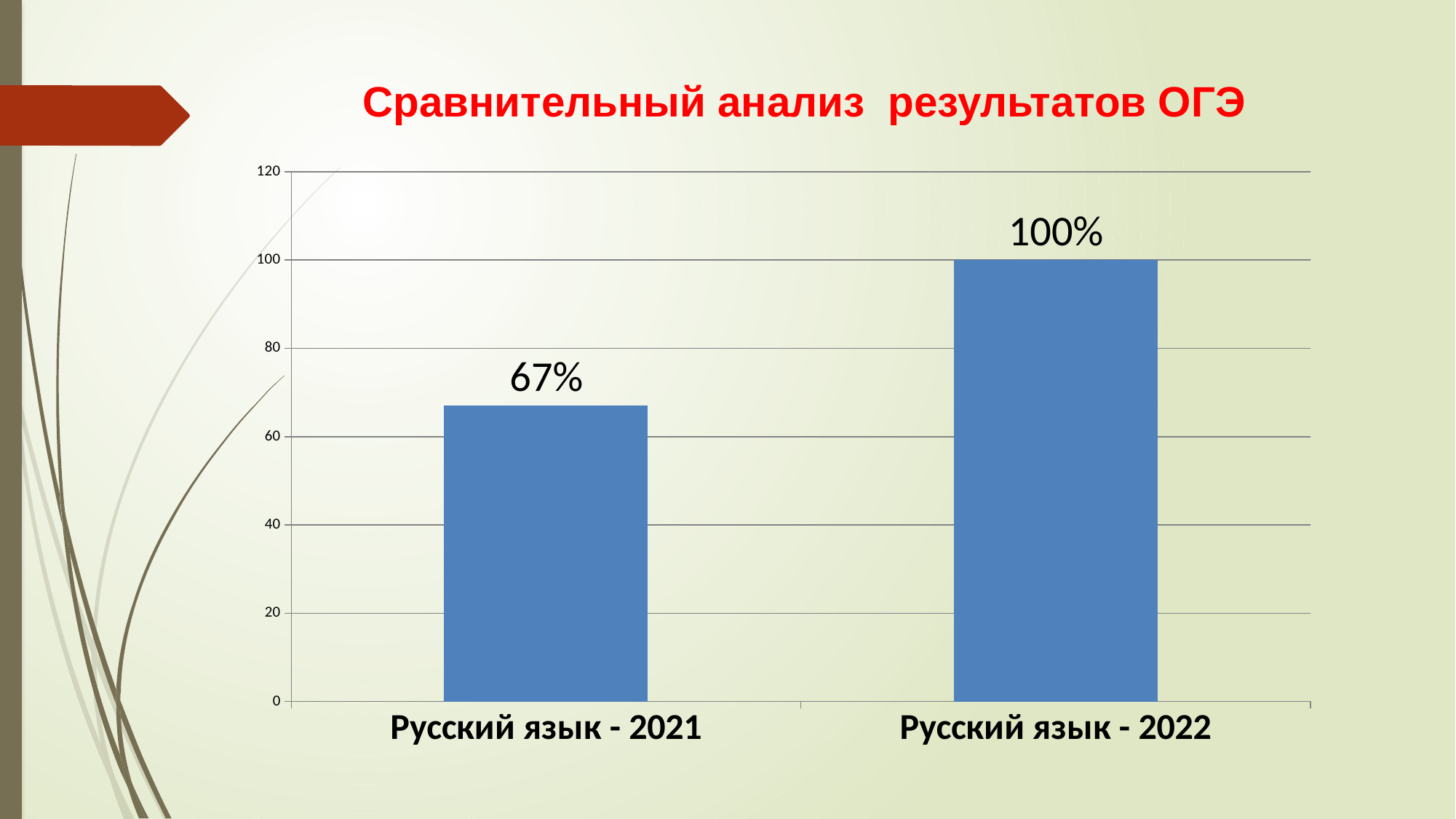
What is the value for Русский язык - 2021? 67% How many categories are shown on the chart? 2 What is the value for Русский язык - 2022? 100% What kind of chart is shown on the slide? bar chart Do the values rise or fall from 2021 to 2022? rise Which category has the lowest value? Русский язык - 2021 Which category has the highest value? Русский язык - 2022 Is the value for Русский язык - 2021 greater or less than 80? less What is the difference between the values for Русский язык - 2022 and Русский язык - 2021? 33% Which is larger, the value for Русский язык - 2021 or Русский язык - 2022? Русский язык - 2022 What is the title of the slide? Сравнительный анализ результатов ОГЭ What is the highest value shown on the vertical axis? 120